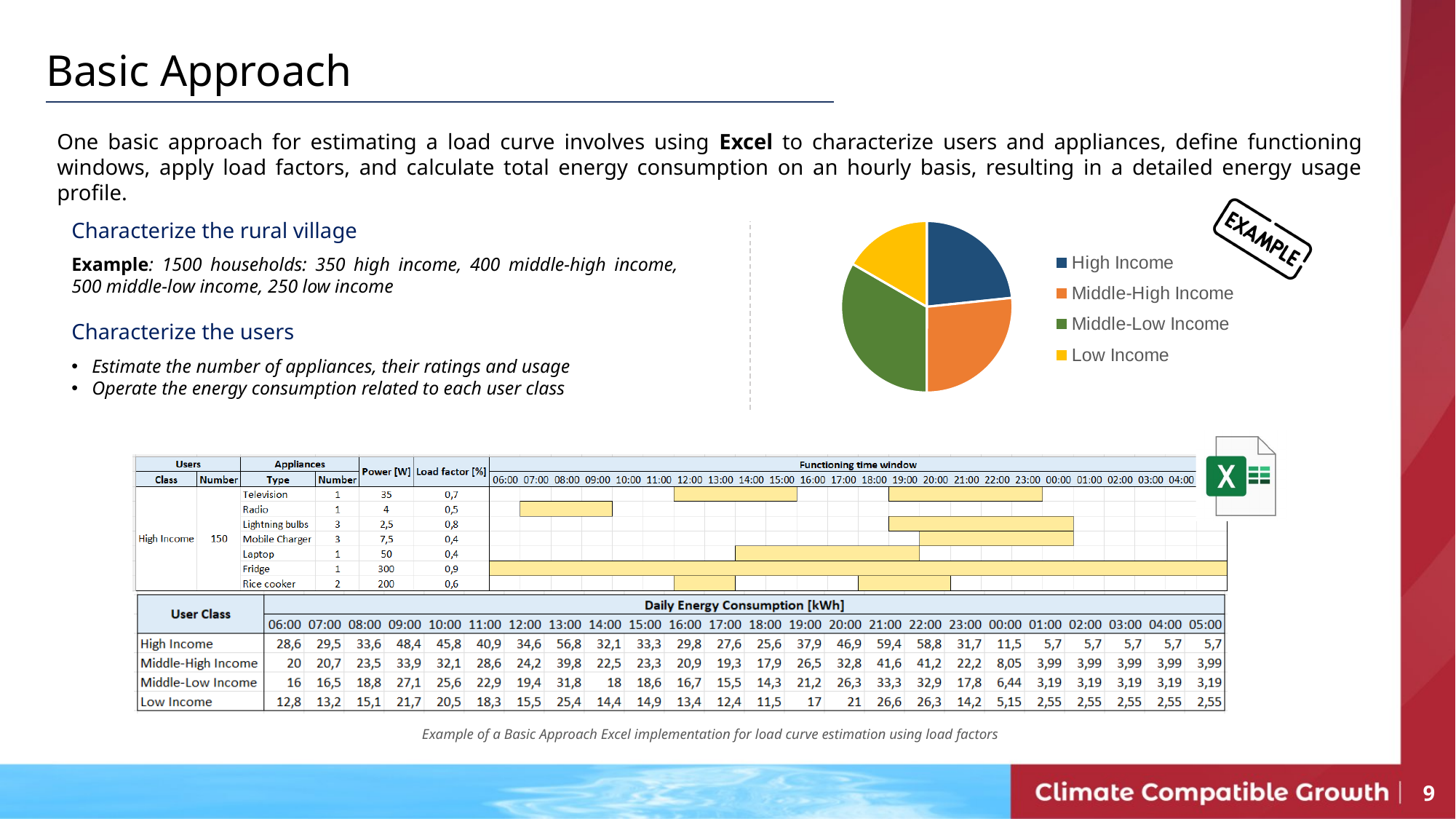
Which user class has the largest slice of the pie chart? Middle-Low Income How many slices does the pie chart have? 4 Which user class has the smallest slice of the pie chart? Low Income What kind of chart is shown on the slide? pie chart In the pie chart, which slice is larger: Middle-Low Income or Low Income? Middle-Low Income What colour represents Low Income in the pie chart? yellow How many entries does the pie chart's legend list? 4 What colour represents Middle-Low Income in the pie chart? green In the pie chart, which slice is larger: High Income or Low Income? High Income